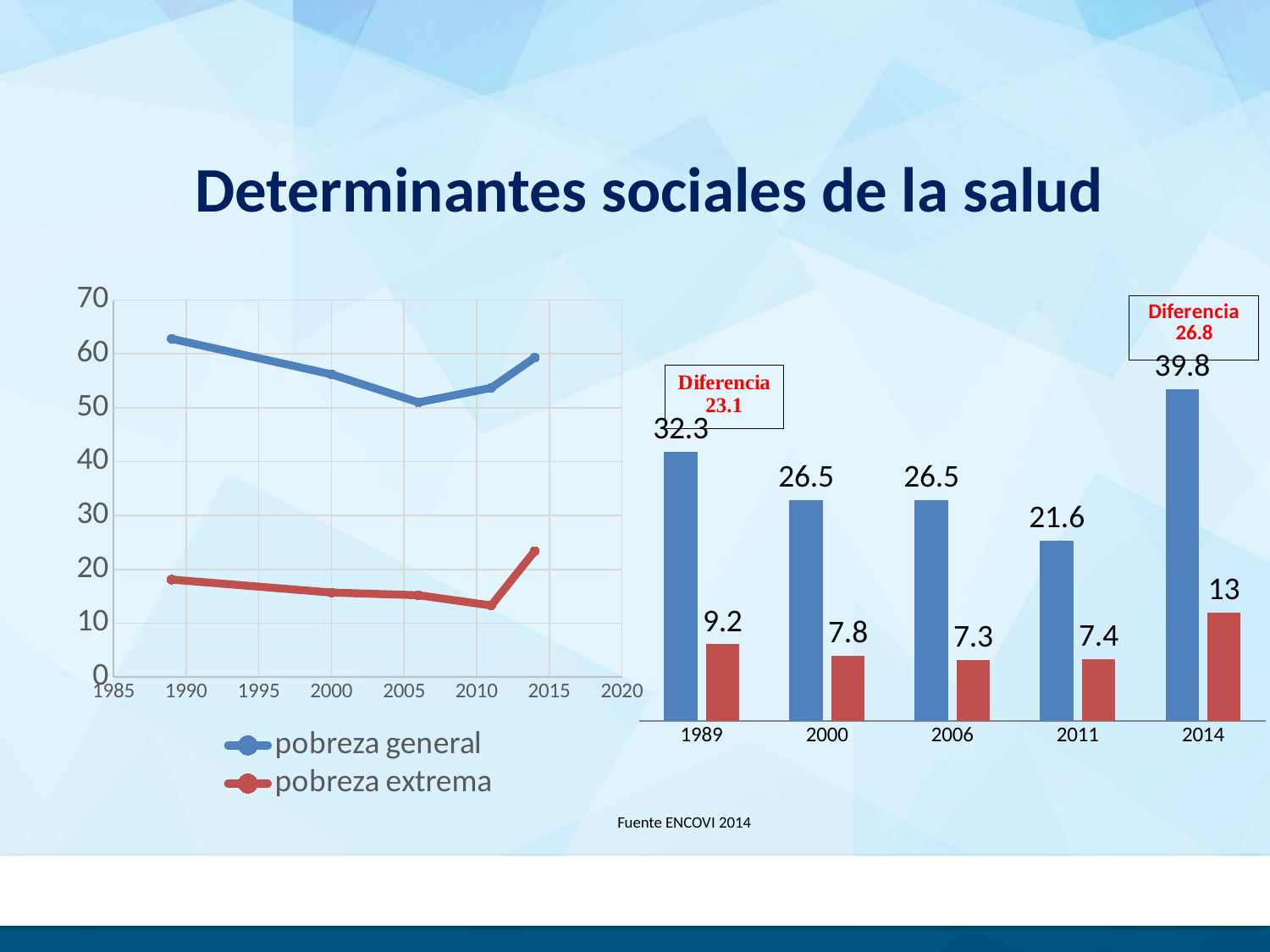
How many years are shown on the x axis of the bar chart on the right? 5 In the line chart on the left, is the value for pobreza general at 1990 greater or less than 60? greater In the bar chart on the right, what is the value of the red bar for 2006? 7.3 In the bar chart on the right, which year has the lowest red bar? 2006 In the bar chart on the right, is the blue bar larger for 1989 or for 2011? 1989 In the line chart on the left, does pobreza general rise or fall between 1990 and 2005? Fall In the bar chart on the right, what is the value of the blue bar for 2014? 39.8 What kind of chart is the chart on the left of the slide? Line chart How many series does the legend of the line chart on the left list? 2 In the bar chart on the right, which year has the highest blue bar? 2014 In the bar chart on the right, what 'Diferencia' value is shown in the box above the 2014 bars? 26.8 In the bar chart on the right, what is the difference between the blue bar and the red bar for 2000? 18.7